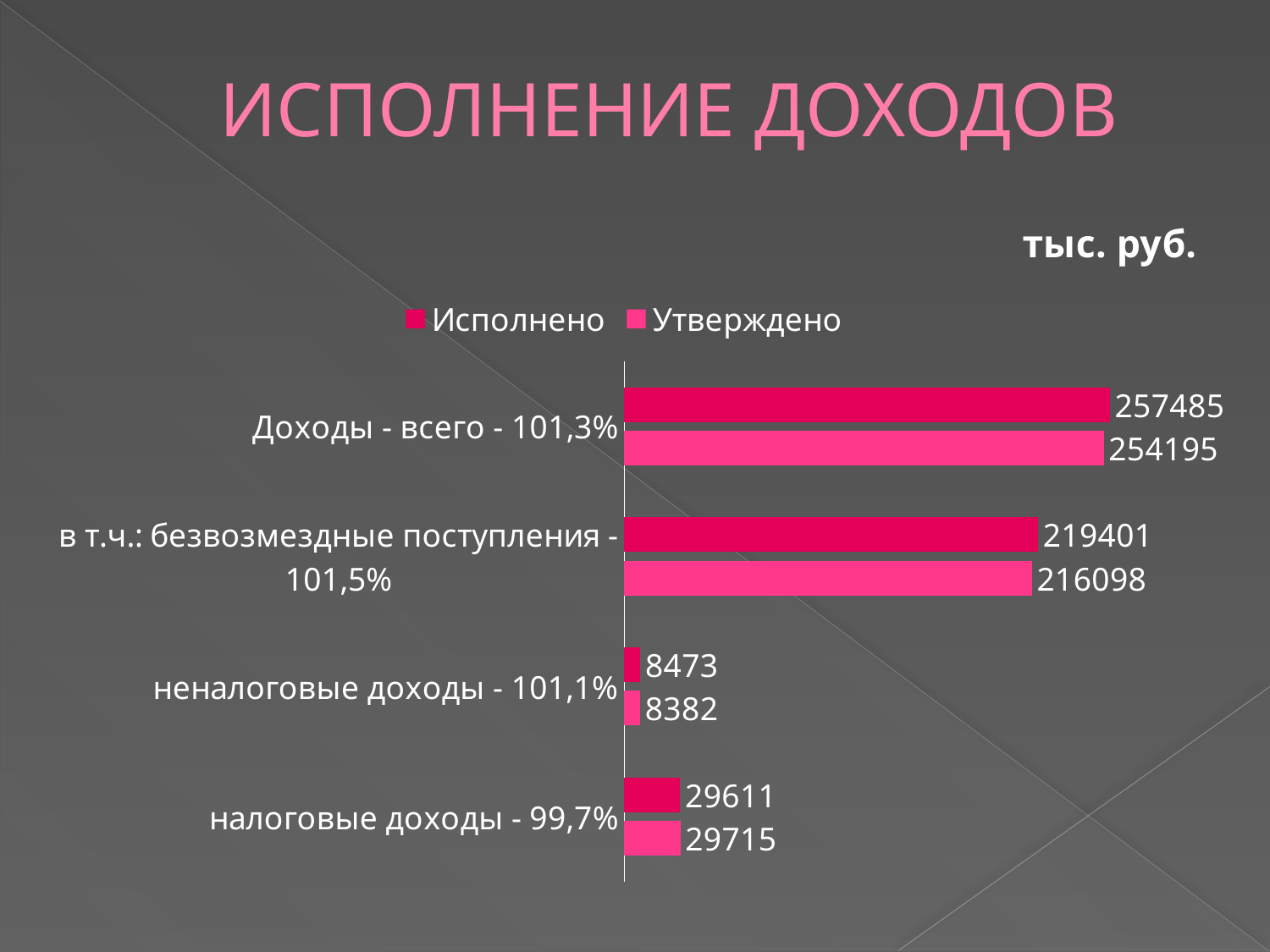
What is the Утверждено value for "налоговые доходы - 99,7%"? 29715 For "налоговые доходы - 99,7%", which is larger: the Исполнено value or the Утверждено value? Утверждено Which category has the highest Утверждено value? Доходы - всего - 101,3% What is the Утверждено value for "в т.ч.: безвозмездные поступления - 101,5%"? 216098 What is the difference between the Исполнено and Утверждено values for "Доходы - всего - 101,3%"? 3290 What is the Исполнено value for "Доходы - всего - 101,3%"? 257485 What is the Исполнено value for "неналоговые доходы - 101,1%"? 8473 How many series does the legend list? 2 What type of chart is shown on the slide? Bar chart What is the difference between the Утверждено and Исполнено values for "налоговые доходы - 99,7%"? 104 How many categories are shown on the chart? 4 Which category has the lowest Исполнено value? неналоговые доходы - 101,1%